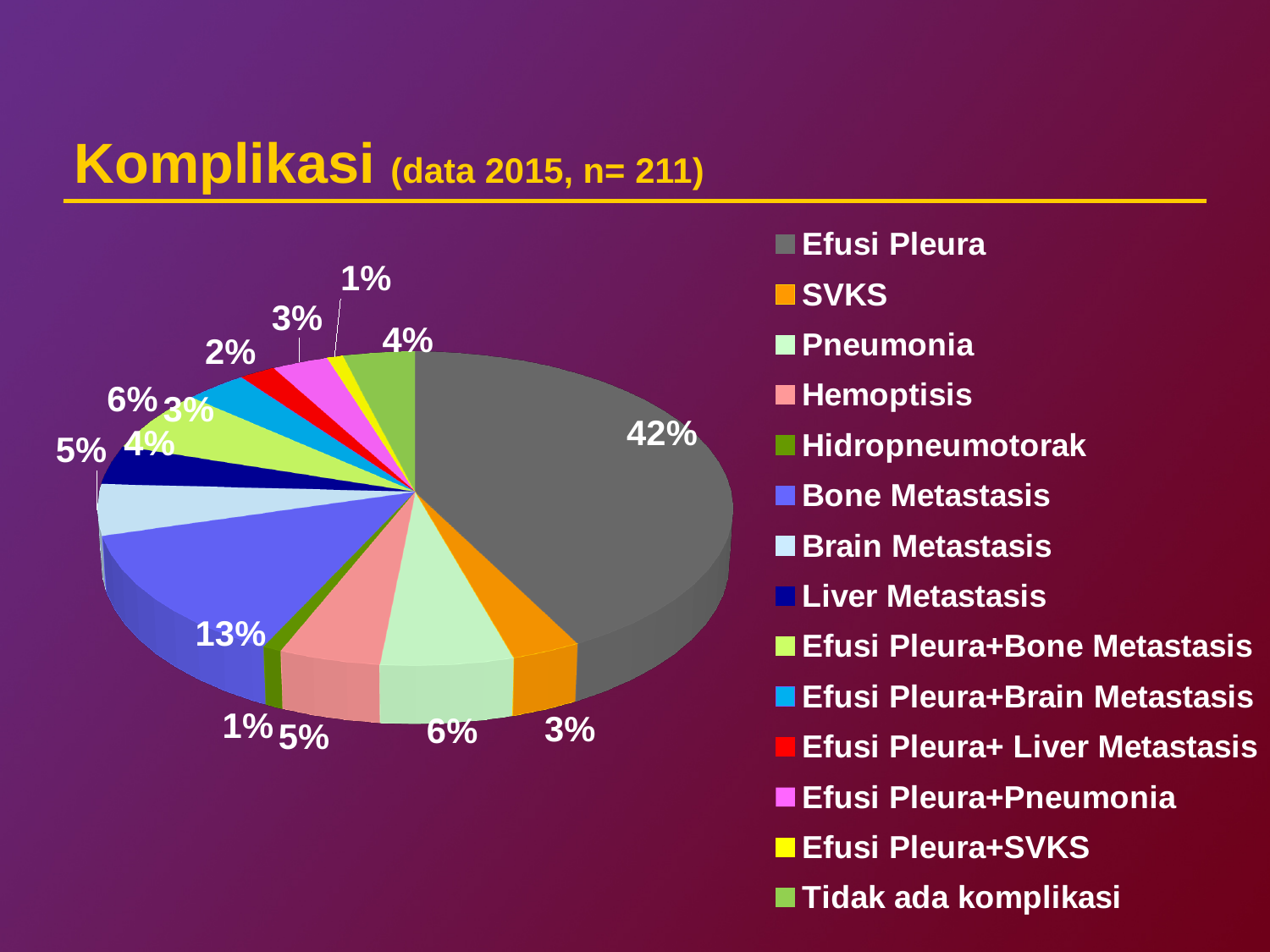
What is the value shown for Pneumonia? 6% What is the value shown for Liver Metastasis? 4% What is the value shown for Bone Metastasis? 13% What is the value shown for Tidak ada komplikasi? 4% What share of the pie does Efusi Pleura have? 42% Which category has the largest share of the pie? Efusi Pleura What kind of chart is shown on the slide? pie chart Which is larger, the share for Hemoptisis or the share for SVKS? Hemoptisis What is the difference in percentage points between Efusi Pleura and Bone Metastasis? 29 What is the title of the slide containing the chart? Komplikasi (data 2015, n= 211) How many categories does the legend of the pie chart list? 14 What is the value shown for Hidropneumotorak? 1%